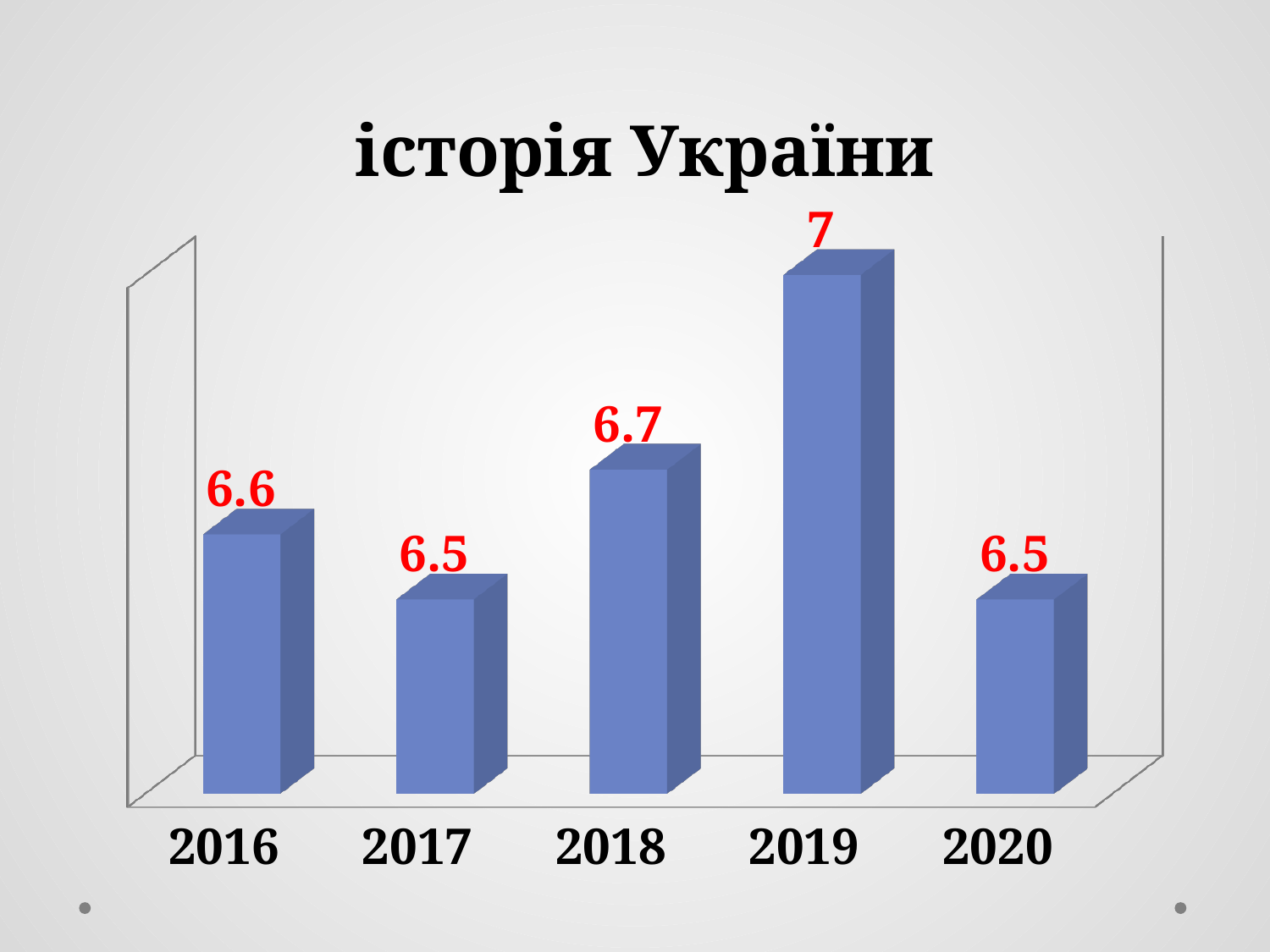
Which year has the highest value? 2019 What is the value for 2019? 7 What is the value for 2018? 6.7 What is the value for 2020? 6.5 How many years are shown on the chart? 5 What kind of chart is shown on the slide? bar chart Does the value rise or fall from 2019 to 2020? fall Which is larger, the value for 2016 or the value for 2017? 2016 What is the difference between the values for 2019 and 2017? 0.5 What is the title of the chart? історія України What is the value for 2016? 6.6 What is the difference between the values for 2018 and 2016? 0.1